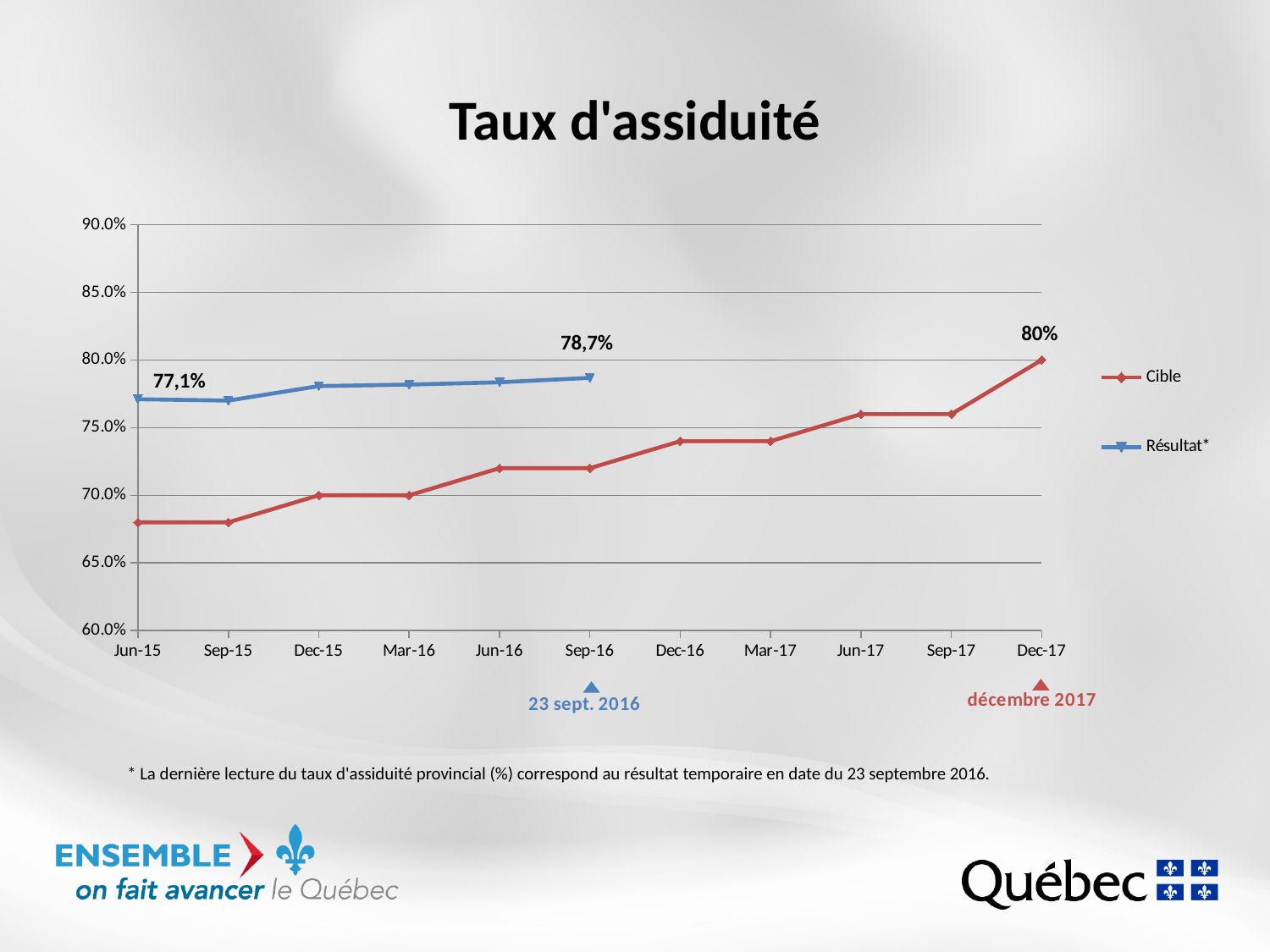
How many series does the legend list? 2 By how much did the Résultat* value increase from Jun-15 to Sep-16? 1,6% What is the Cible value at Dec-17? 80% At Sep-16, which series has the higher value, Cible or Résultat*? Résultat* What is the Résultat* value at Sep-16? 78,7% What is the Résultat* value at Jun-15? 77,1% How many dates are shown on the x axis? 11 Is the Cible value at Jun-15 greater or less than 70.0%? less What kind of chart is shown on the slide? line chart Is the Cible value at Mar-17 greater or less than 75.0%? less What is the title of the chart? Taux d'assiduité Does the Cible series rise or fall from Jun-15 to Dec-17? rise